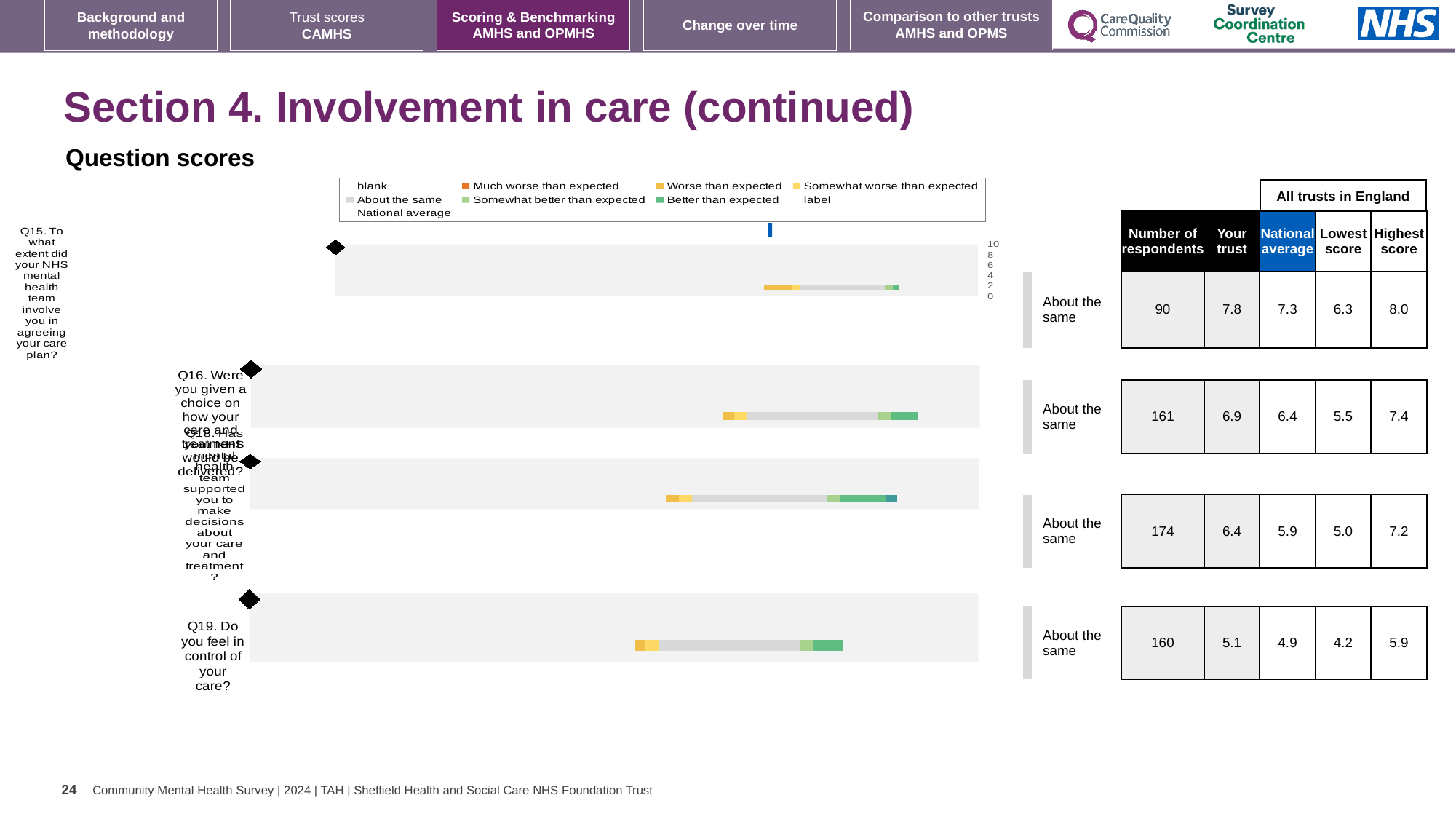
In the table beside the chart, what is the highest score for Q19? 5.9 By how much does the 'Your trust' score for Q15 exceed the national average for Q15 in the table beside the chart? 0.5 In the table beside the chart, what is the 'Your trust' score for Q15? 7.8 For Q16, which is larger in the table beside the chart: the 'Your trust' score or the national average? Your trust Which question has the lowest 'Your trust' score in the table beside the chart? Q19 What kind of chart is used to show the question scores on this slide? bar chart Which question has the highest 'Your trust' score in the table beside the chart? Q15 In the table beside the chart, what is the national average for Q18? 5.9 How many entries does the legend of the question scores chart list? 9 In the table beside the chart, how many respondents are listed for Q16? 161 What is the highest tick value shown on the axis of the question scores chart? 10 How many questions (categories) are plotted in the question scores chart? 4